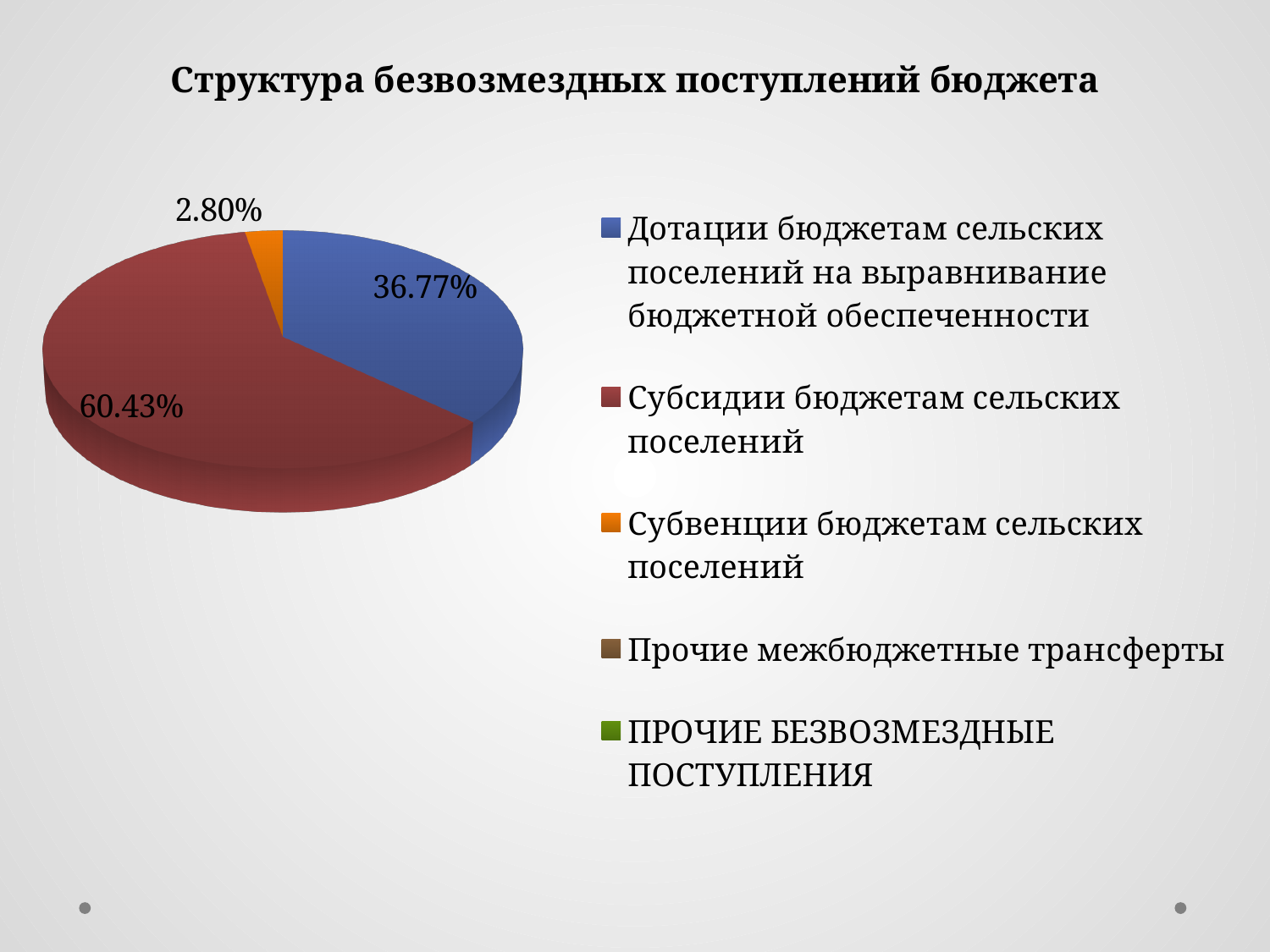
How many entries does the legend of the chart list? 5 By how many percentage points does the share for Субсидии бюджетам сельских поселений exceed the share for Субвенции бюджетам сельских поселений? 57.63 percentage points What percentage does the pie chart show for Субсидии бюджетам сельских поселений? 60.43% By how many percentage points does the share for Субсидии бюджетам сельских поселений exceed the share for Дотации бюджетам сельских поселений на выравнивание бюджетной обеспеченности? 23.66 percentage points Which is larger: the share for Дотации бюджетам сельских поселений на выравнивание бюджетной обеспеченности or the share for Субсидии бюджетам сельских поселений? Субсидии бюджетам сельских поселений What percentage does the pie chart show for Дотации бюджетам сельских поселений на выравнивание бюджетной обеспеченности? 36.77% Which category has the largest slice of the pie chart? Субсидии бюджетам сельских поселений What type of chart is shown on the slide? Pie chart Which of the labelled slices in the pie chart is the smallest? Субвенции бюджетам сельских поселений Is the share for Субсидии бюджетам сельских поселений greater or less than 50%? greater What percentage does the pie chart show for Субвенции бюджетам сельских поселений? 2.80% What is the title of the chart on the slide? Структура безвозмездных поступлений бюджета